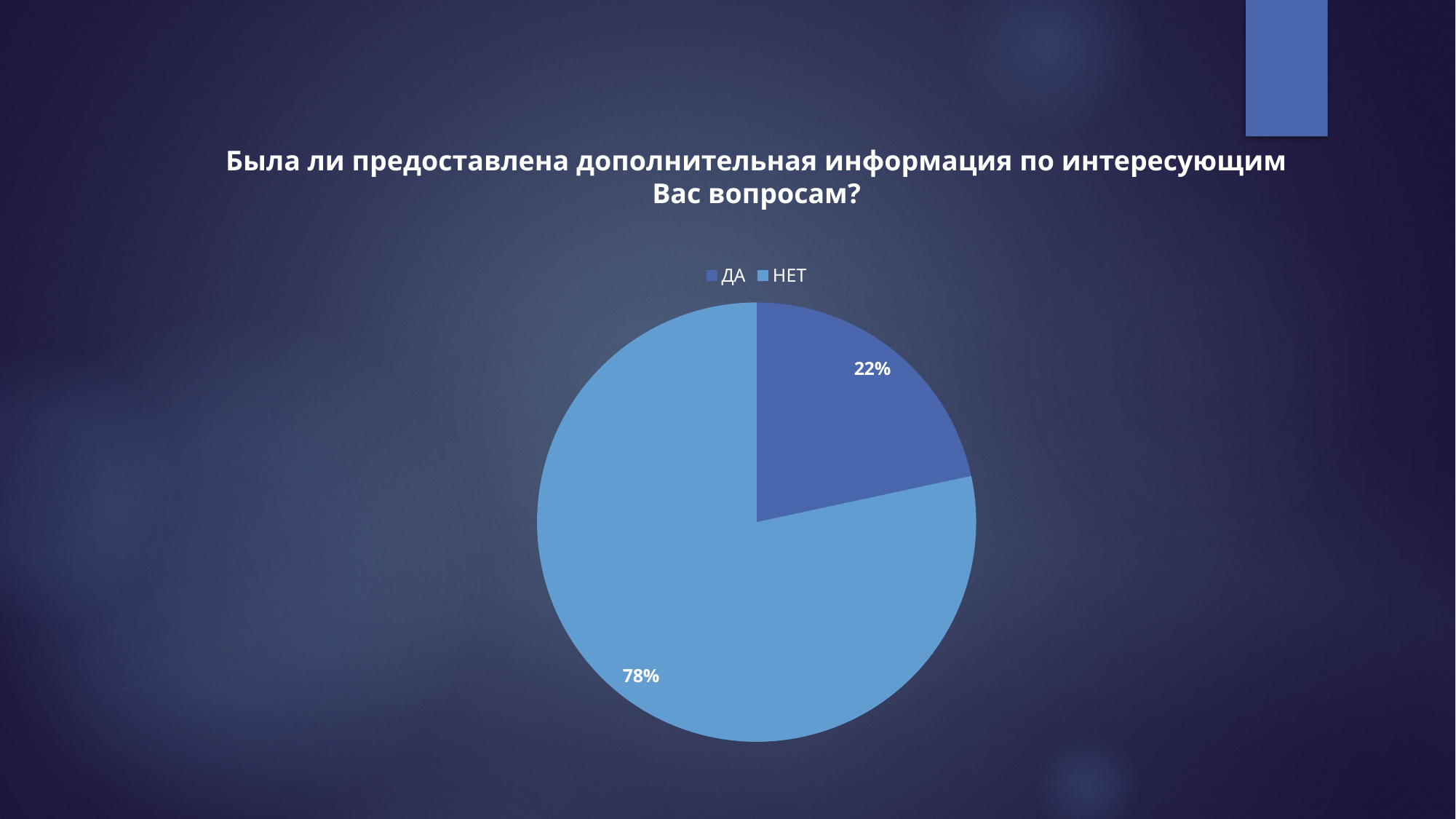
What is the title of the chart? Была ли предоставлена дополнительная информация по интересующим Вас вопросам? Which category has the smallest slice of the pie? ДА Which slice is larger, ДА or НЕТ? НЕТ What is the difference in percentage points between the НЕТ and ДА slices? 56 What share of the pie does НЕТ represent? 78% Which legend entry is shown in the darker blue colour? ДА What share of the pie does ДА represent? 22% How many entries does the legend list? 2 Is the value for ДА greater or less than 50%? less How many categories does the pie chart show? 2 Which category has the largest slice of the pie? НЕТ What kind of chart is shown on the slide? pie chart